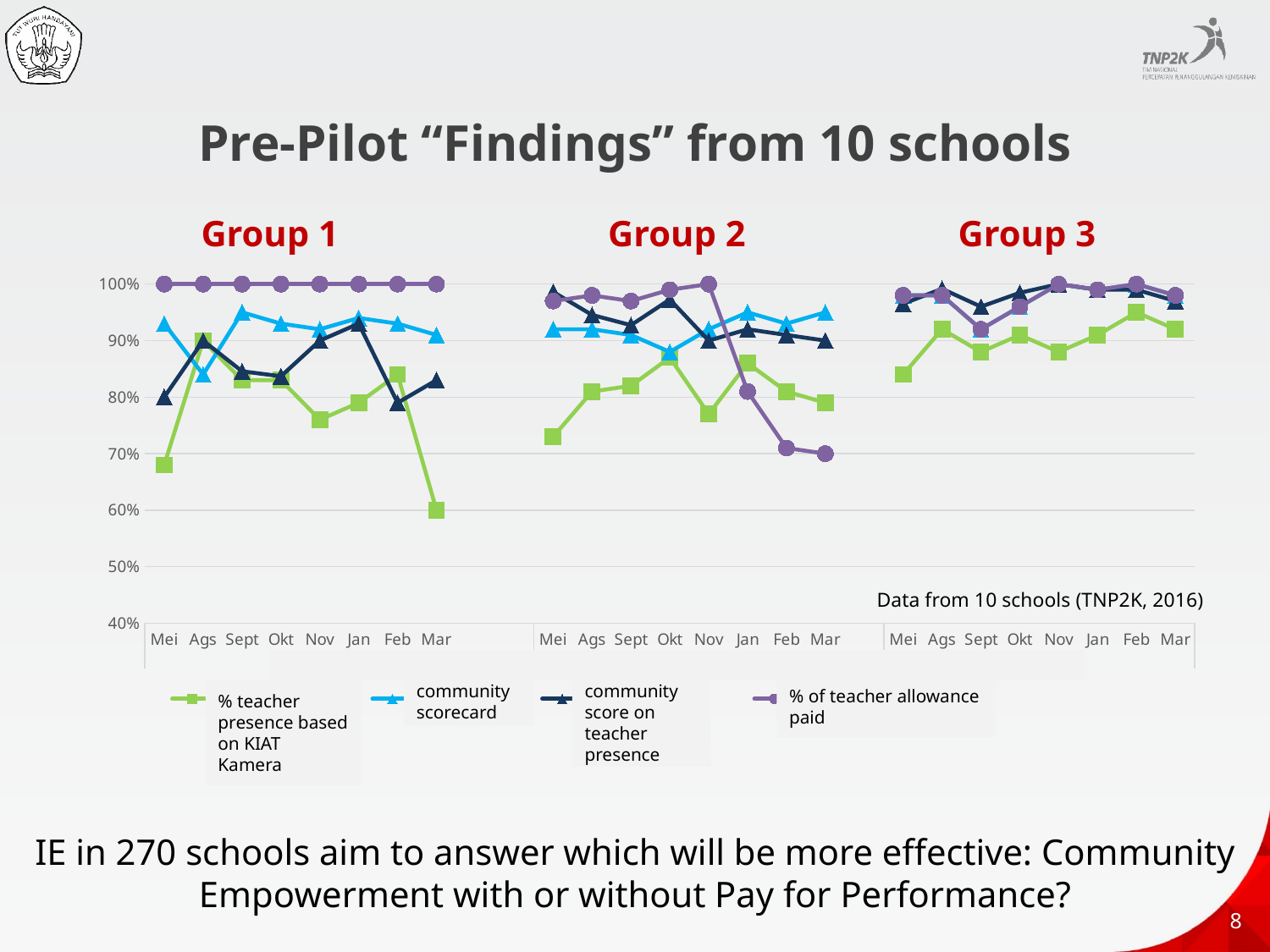
What kind of chart is shown on the slide? line chart How many series does the legend list? 4 In Group 1, what is the value for % of teacher allowance paid in Mei? 100% In Group 1, which series has the highest value in Mar? % of teacher allowance paid How many months are plotted on the x axis for Group 1? 8 In Group 2, does the % of teacher allowance paid rise or fall from Nov to Mar? fall In Group 2 in Mar, which is larger: % teacher presence based on KIAT Kamera or % of teacher allowance paid? % teacher presence based on KIAT Kamera In Group 1, is the value for % teacher presence based on KIAT Kamera in Mei greater or less than 70%? less In Group 2, is the value for % of teacher allowance paid in Mar greater or less than 80%? less In Group 3, is the value for % teacher presence based on KIAT Kamera in Mei greater or less than 90%? less What is the title of the slide's chart section? Pre-Pilot "Findings" from 10 schools In Group 1, which series has the lowest value in Mei? % teacher presence based on KIAT Kamera